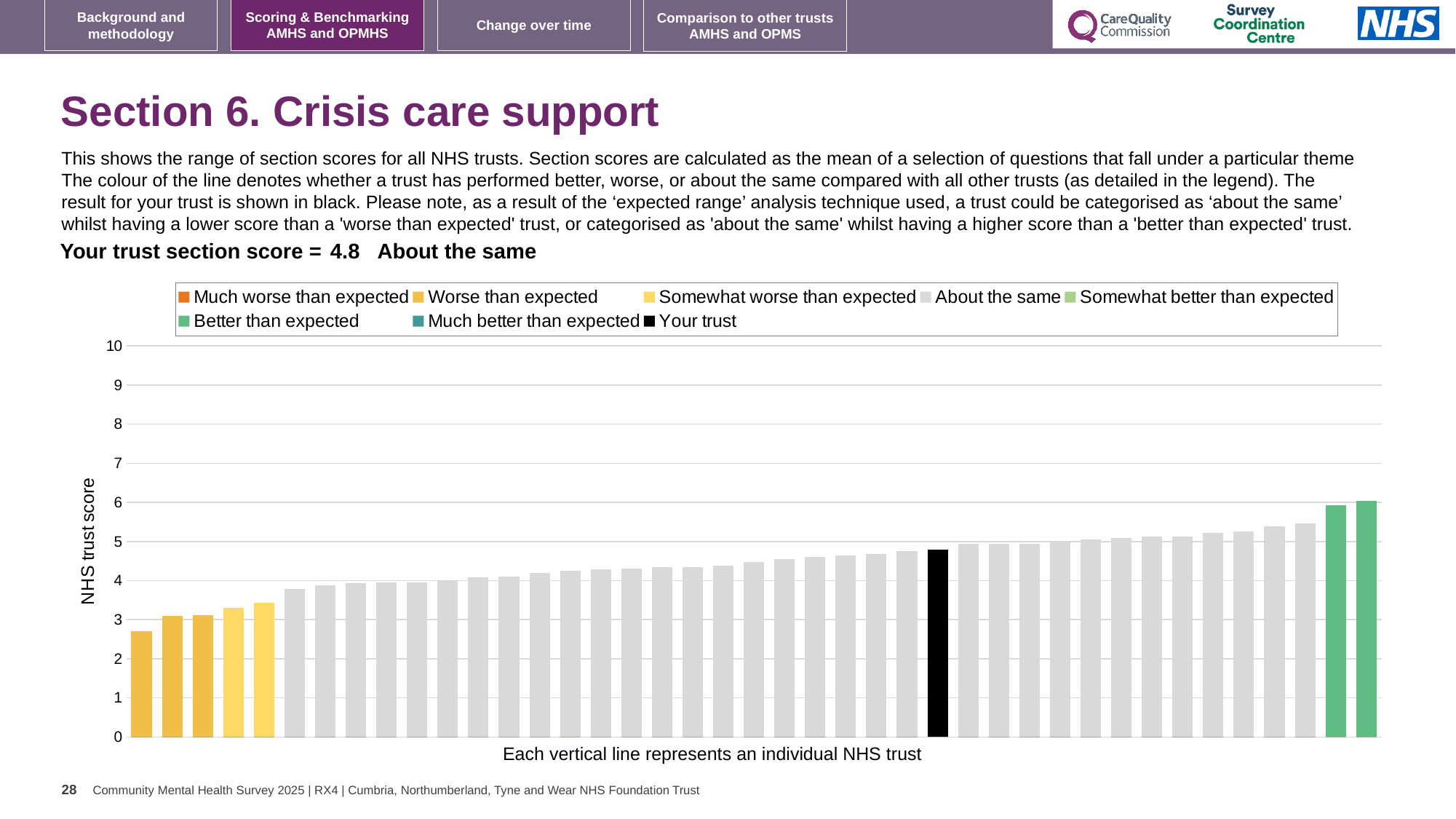
How many bars are coloured as 'Worse than expected' (dark yellow)? 3 Which performance category is your trust placed in for this section? About the same How many entries does the chart legend list? 8 Which is larger: the black 'Your trust' bar or the rightmost green bar? the rightmost green bar What is the label on the vertical axis of the chart? NHS trust score How many bars are coloured as 'Better than expected' (green)? 2 Is the value of the shortest bar in the chart greater or less than 3? less Do the bar values rise or fall from left to right along the x axis? rise Is the value of the tallest bar in the chart greater or less than 5? greater What kind of chart is shown on the slide? bar chart What is the section score for your trust shown on the slide? 4.8 Is the value of the black 'Your trust' bar greater or less than 4? greater